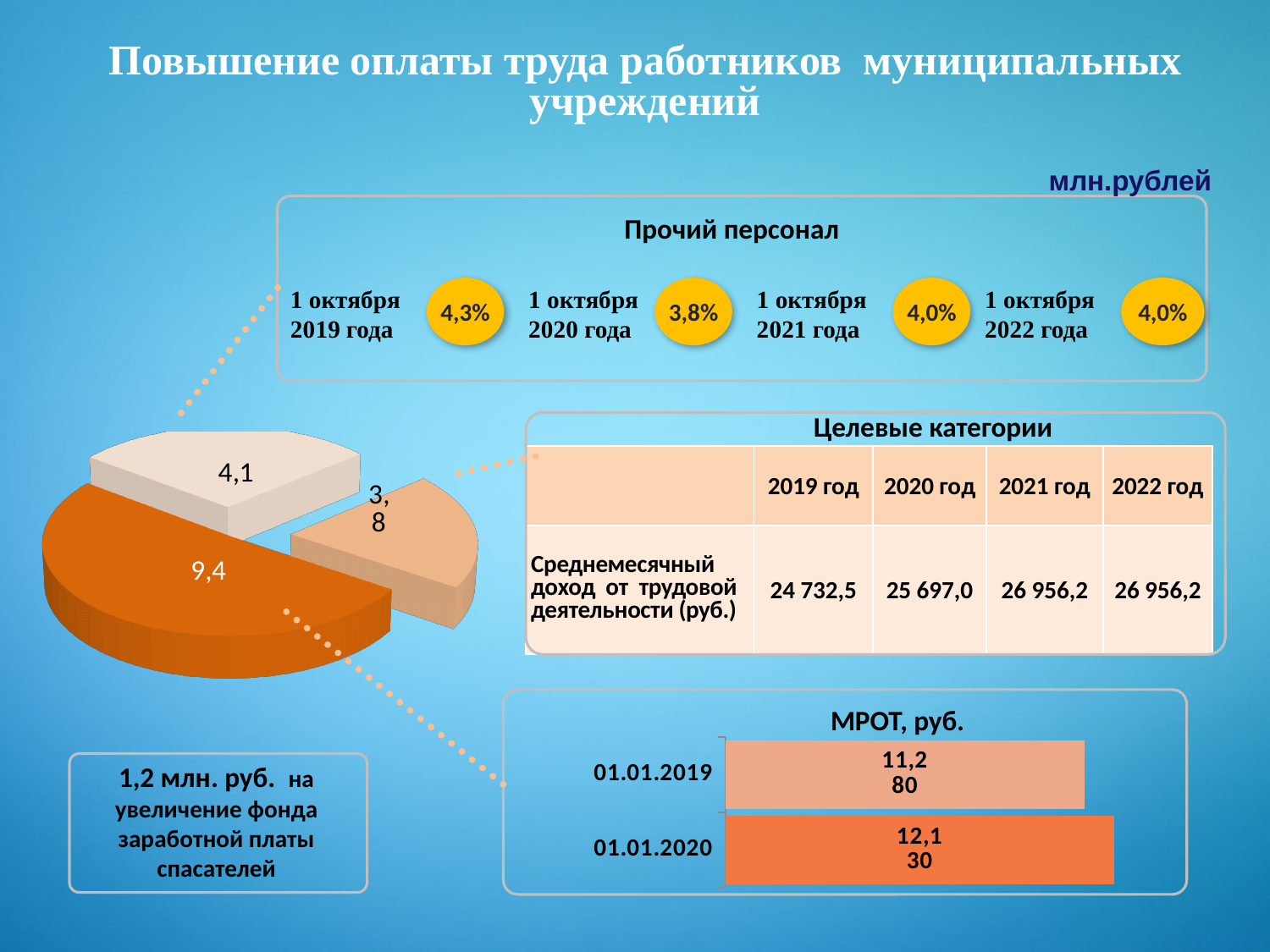
What is the total of the three slice values in the pie chart on the left? 17,3 What is the value of the largest slice in the pie chart on the left? 9,4 In the chart titled 'МРОТ, руб.', what is the value for 01.01.2019? 11,280 In the chart titled 'МРОТ, руб.', which date has the larger value: 01.01.2019 or 01.01.2020? 01.01.2020 In the chart titled 'МРОТ, руб.', what is the value for 01.01.2020? 12,130 In the pie chart on the left, which is larger: the slice labelled 4,1 or the slice labelled 3,8? 4,1 In the chart titled 'МРОТ, руб.', by how much does the value for 01.01.2020 exceed the value for 01.01.2019? 850 What kind of chart is the chart titled 'МРОТ, руб.'? bar chart What is the value of the smallest slice in the pie chart on the left? 3,8 What kind of chart is the chart on the left of the slide? pie chart How many slices does the pie chart on the left have? 3 How many bars does the chart titled 'МРОТ, руб.' have? 2